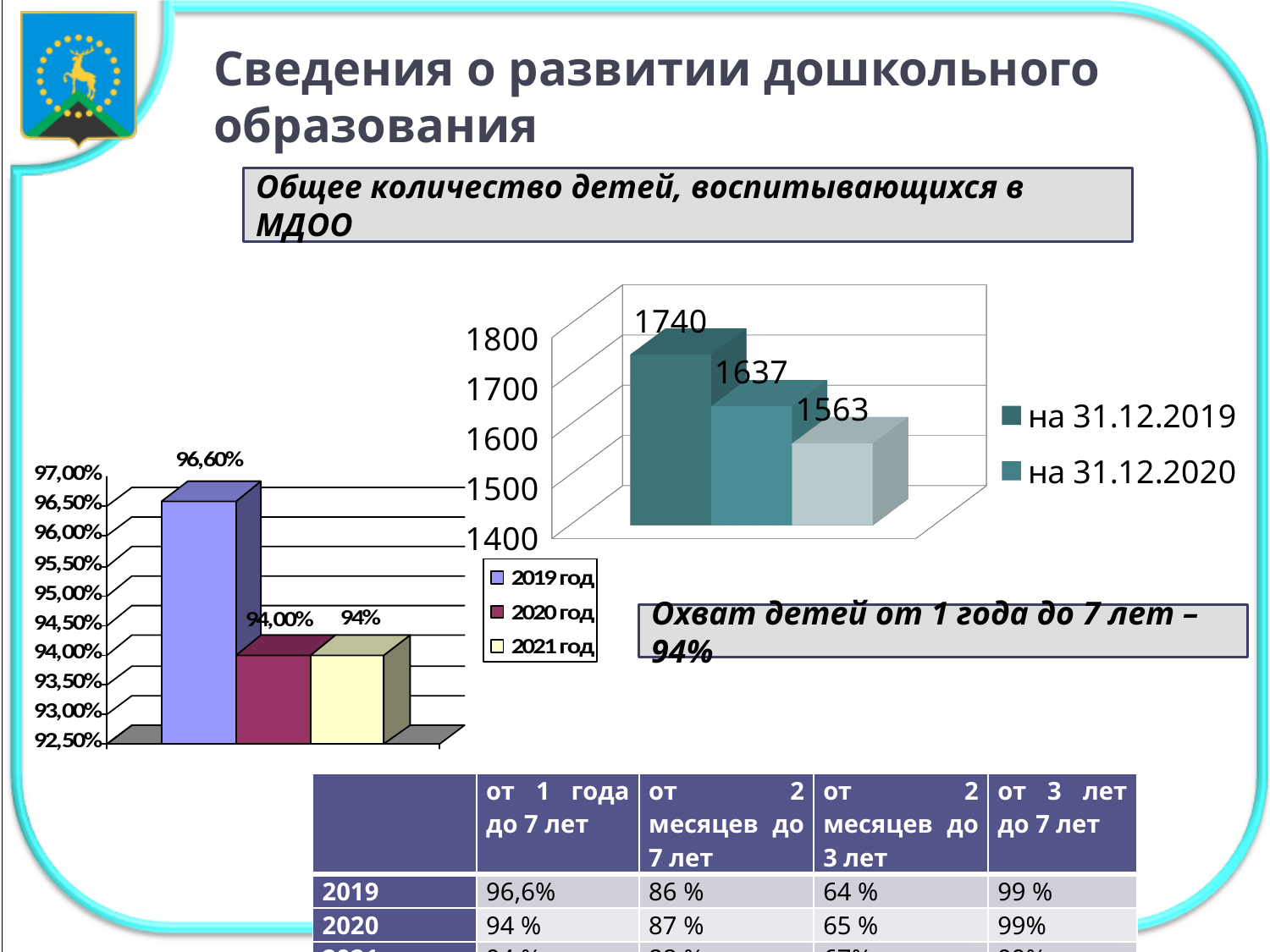
On the chart on the right (Общее количество детей, воспитывающихся в МДОО), what is the value for на 31.12.2020? 1637 On the chart on the right (Общее количество детей, воспитывающихся в МДОО), what is the value of the lowest bar? 1563 On the chart on the left, how many series does the legend list? 3 On the chart on the right (Общее количество детей, воспитывающихся в МДОО), what is the difference between the values for на 31.12.2019 and на 31.12.2020? 103 On the chart on the right (Общее количество детей, воспитывающихся в МДОО), do the values rise or fall from left to right? fall On the chart on the left, what is the value for 2019 год? 96,60% On the chart on the left, which series has the highest value? 2019 год On the chart on the right (Общее количество детей, воспитывающихся в МДОО), how many bars are plotted? 3 On the chart on the left, what is the value for 2021 год? 94% What kind of chart is the chart on the left? bar chart On the chart on the right (Общее количество детей, воспитывающихся в МДОО), what is the value for на 31.12.2019? 1740 On the chart on the left, what is the value for 2020 год? 94,00%